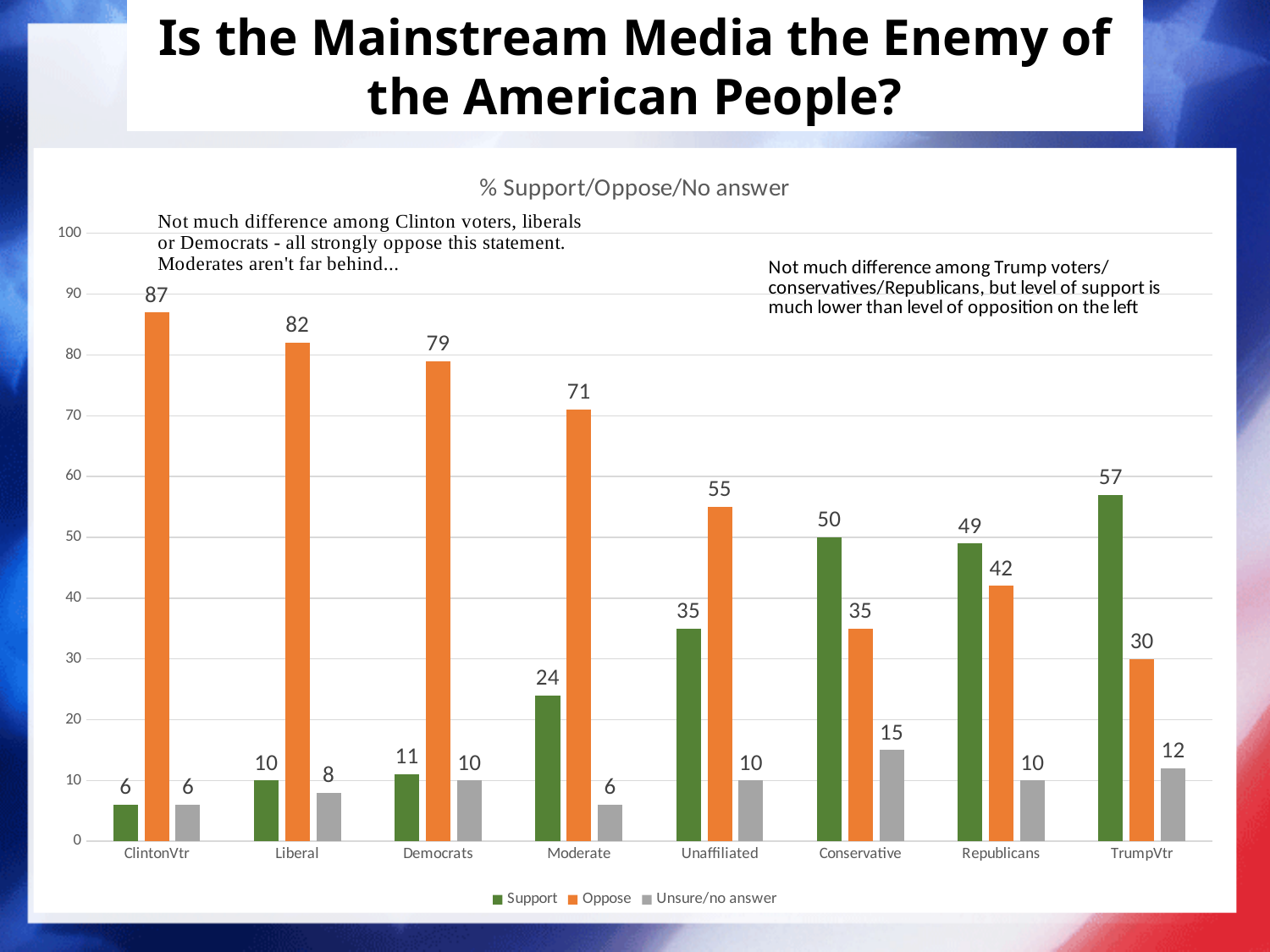
Which category has the lowest Support value? ClintonVtr How many categories are shown on the x axis? 8 Do the Oppose values rise or fall from ClintonVtr to TrumpVtr along the x axis? Fall How many series does the legend list? 3 What is the title of the chart? % Support/Oppose/No answer For Republicans, which is larger: Support or Oppose? Support What kind of chart is shown on the slide? Bar chart What is the Support value for TrumpVtr? 57 Which category has the highest Oppose value? ClintonVtr What is the Oppose value for ClintonVtr? 87 What is the difference between the Oppose value for Liberal and the Oppose value for Democrats? 3 What is the Unsure/no answer value for Conservative? 15